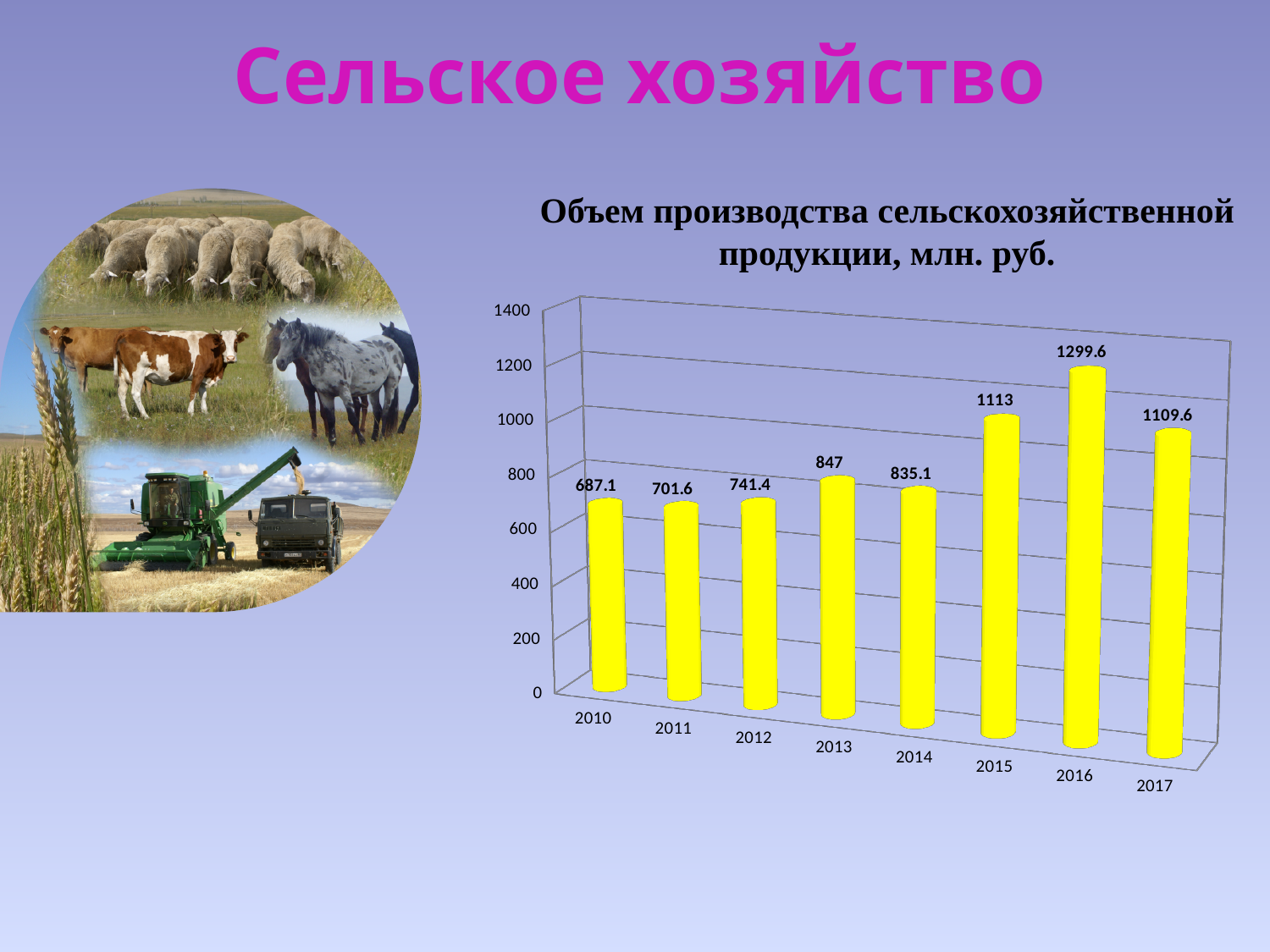
What is the title of the chart? Объем производства сельскохозяйственной продукции, млн. руб. How many years are shown on the chart? 8 What is the difference between the values for 2016 and 2017? 190 Which year has the highest value? 2016 What is the difference between the values for 2015 and 2014? 277.9 What is the value for 2010? 687.1 Which is larger, the value for 2013 or the value for 2014? 2013 What is the value for 2013? 847 What is the value for 2016? 1299.6 Is the value for 2015 greater or less than 1000? greater What kind of chart is shown on the slide? bar chart Which year has the lowest value? 2010